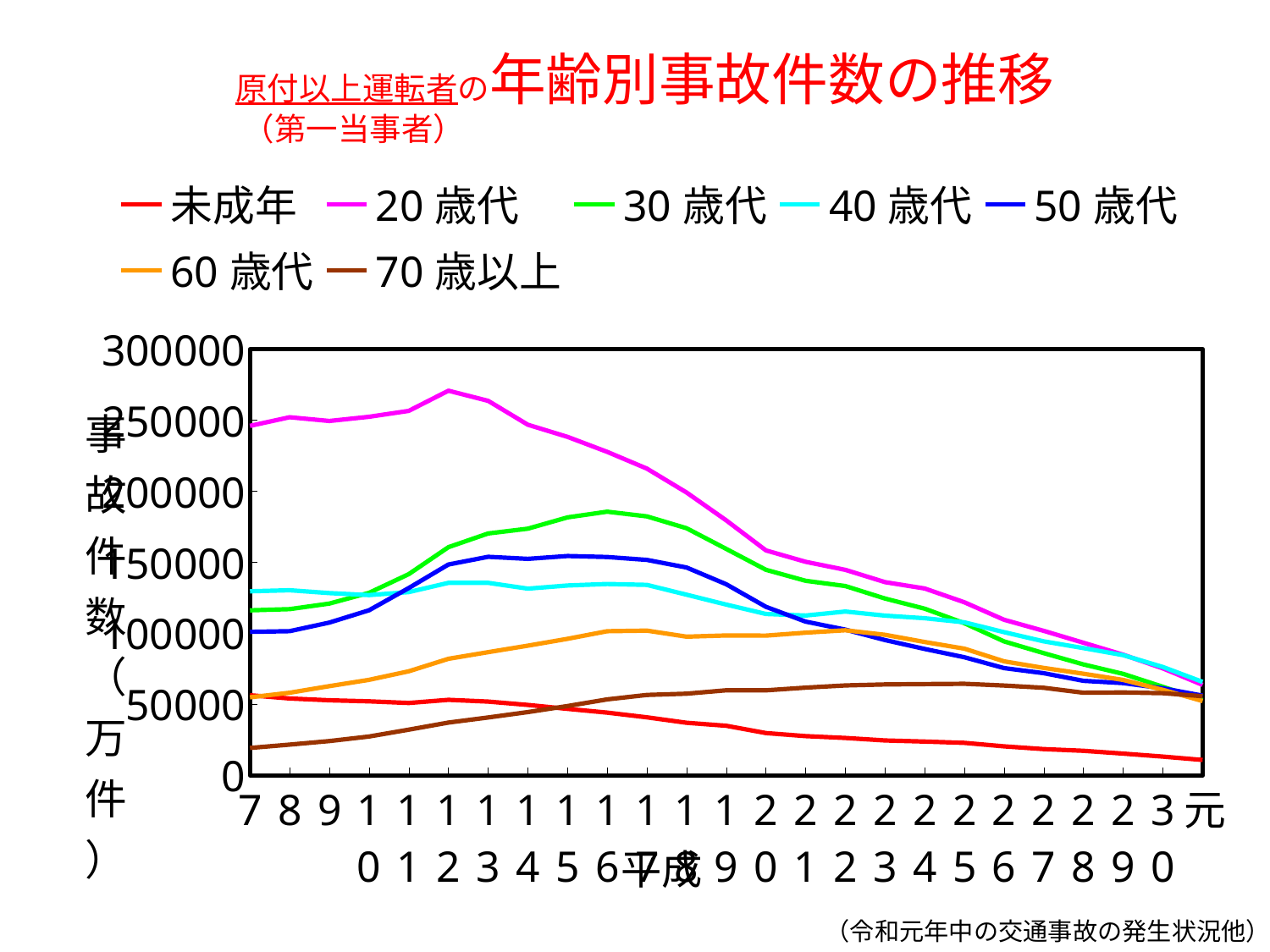
Is the value for 70歳以上 at 平成7 greater or less than 50000? less Is the value for 20歳代 at 平成12 greater or less than 250000? greater How many series does the legend list? 7 Is the value for 未成年 at 令和元 greater or less than 50000? less What kind of chart is shown on the slide? line chart Does the 未成年 series rise or fall from 平成7 to 令和元? fall What colour is the line for 未成年 in the legend? red Which is larger at 令和元, the value for 未成年 or the value for 70歳以上? 70歳以上 Which series has the lowest value at 平成7? 70歳以上 What is the highest value shown on the vertical axis? 300000 Which series has the highest value at 平成7? 20歳代